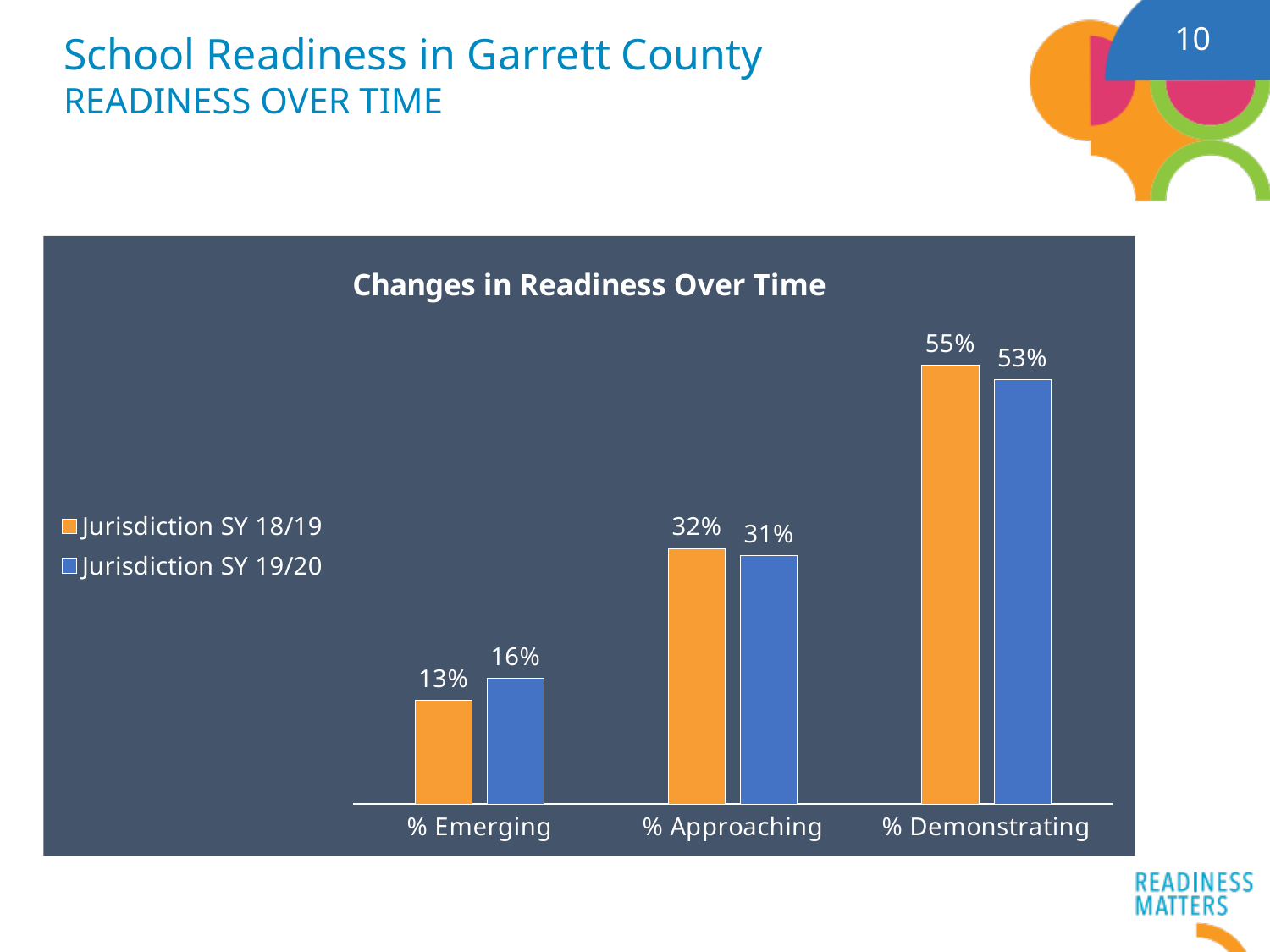
For % Emerging, which series has the larger value, Jurisdiction SY 18/19 or Jurisdiction SY 19/20? Jurisdiction SY 19/20 Which category has the lowest value in the Jurisdiction SY 19/20 series? % Emerging How many series does the legend list? 2 What is the value for % Emerging in the Jurisdiction SY 18/19 series? 13% What is the value for % Demonstrating in the Jurisdiction SY 19/20 series? 53% Which category has the highest value in the Jurisdiction SY 18/19 series? % Demonstrating What is the title of the chart? Changes in Readiness Over Time What kind of chart is shown on the slide? Bar chart What is the difference between the Jurisdiction SY 18/19 and Jurisdiction SY 19/20 values for % Demonstrating? 2% What is the difference between the Jurisdiction SY 18/19 and Jurisdiction SY 19/20 values for % Emerging? 3% What is the value for % Approaching in the Jurisdiction SY 19/20 series? 31% How many categories are shown on the x axis? 3